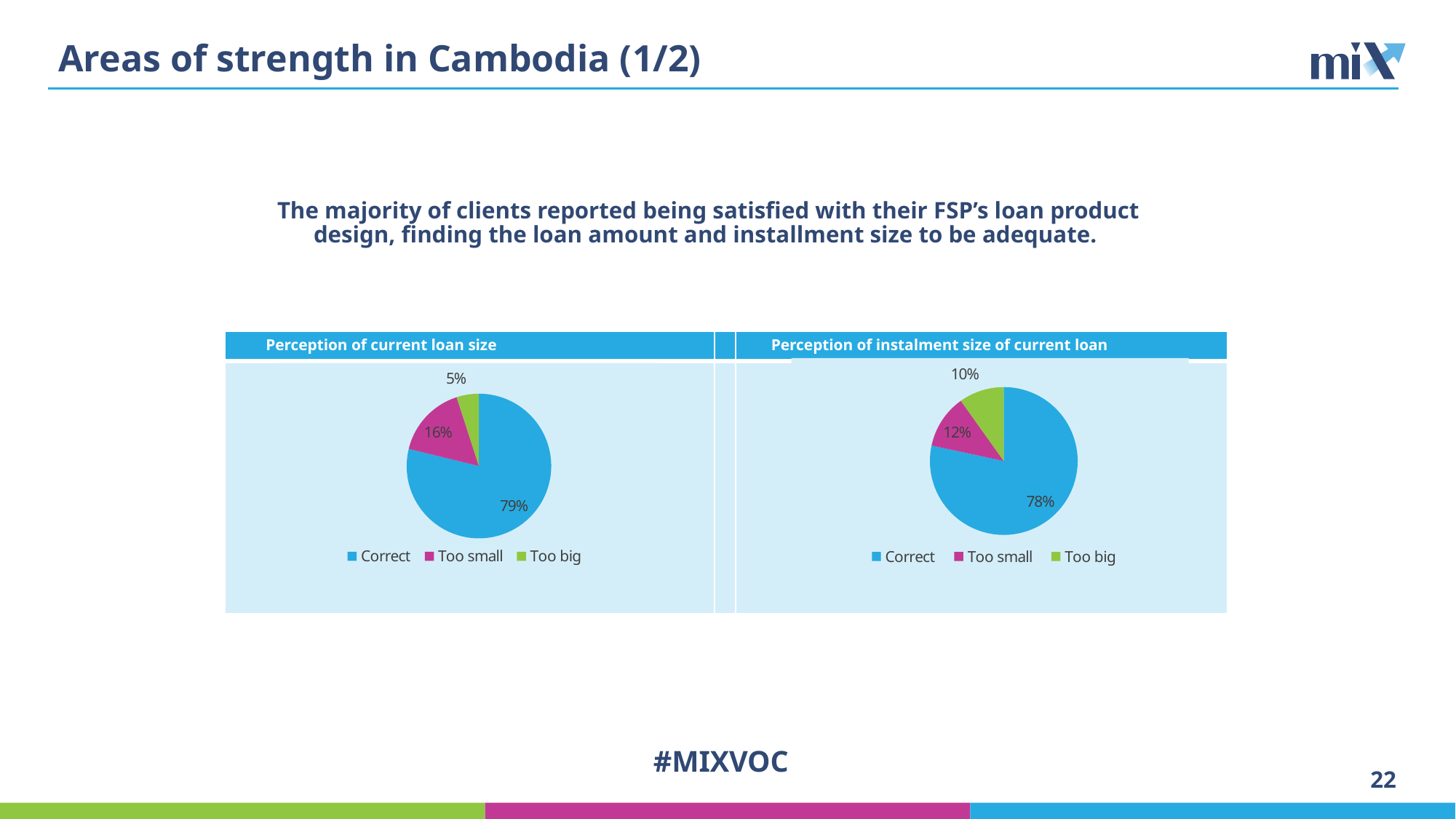
In the 'Perception of instalment size of current loan' chart, what percentage of clients found the instalment Too small? 12% In the 'Perception of current loan size' chart, what percentage of clients found the loan Too big? 5% In the 'Perception of instalment size of current loan' chart, which category has the largest slice? Correct In the 'Perception of instalment size of current loan' chart, what percentage of clients found the instalment Too big? 10% In the 'Perception of current loan size' chart, what share of clients said the loan size was Correct? 79% In the 'Perception of current loan size' chart, what is the difference between the Too small and Too big shares? 11% How many categories does the legend of the 'Perception of instalment size of current loan' chart list? 3 In the 'Perception of instalment size of current loan' chart, what share of clients said the instalment size was Correct? 78% In the 'Perception of instalment size of current loan' chart, is the Too small slice larger or smaller than the Too big slice? larger In the 'Perception of current loan size' chart, which category has the smallest slice? Too big In the 'Perception of current loan size' chart, what percentage of clients found the loan Too small? 16% What type of chart is used in the 'Perception of current loan size' panel? Pie chart